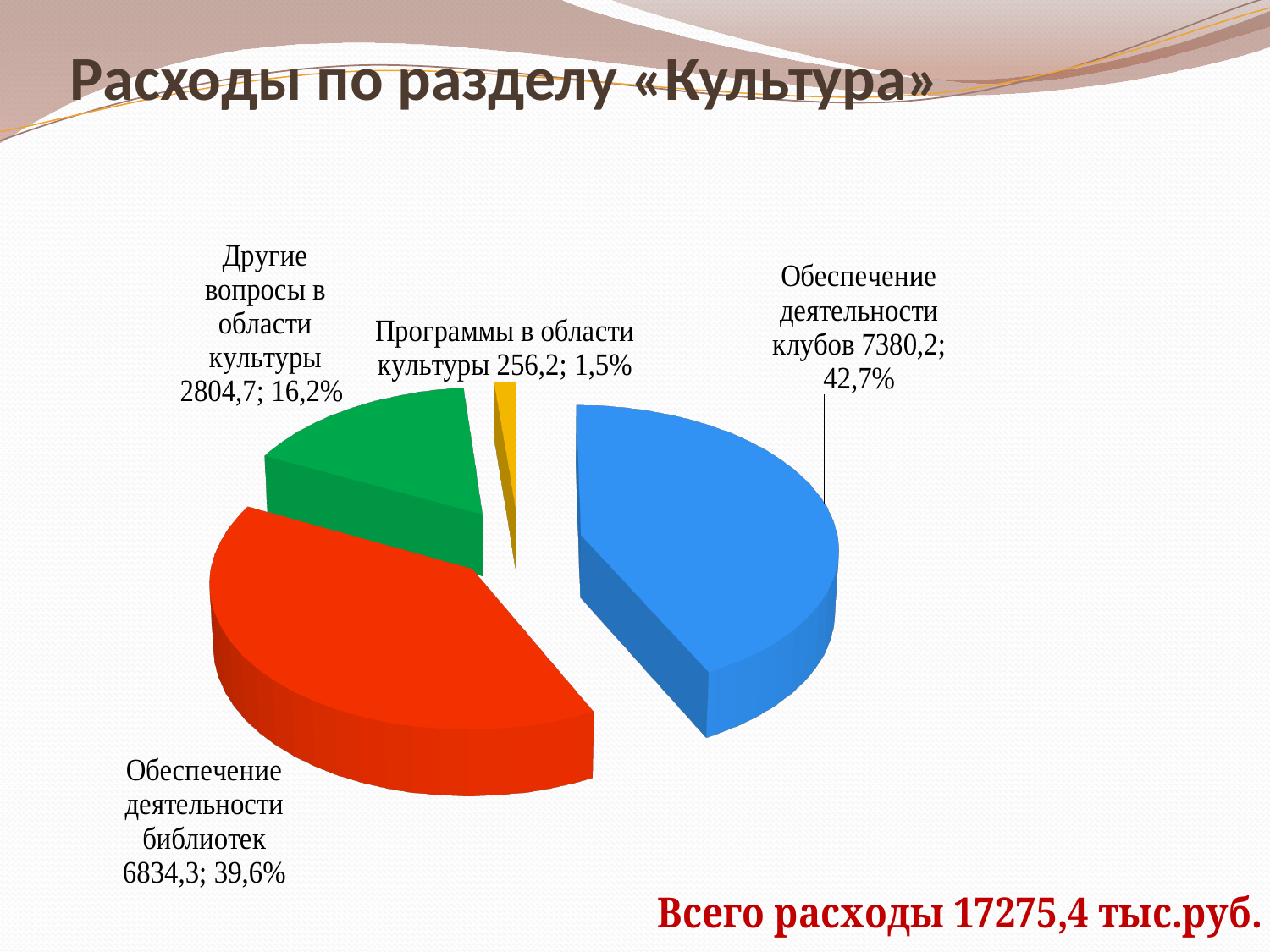
What is the title of the chart on the slide? Расходы по разделу «Культура» How many slices does the pie chart have? 4 What is the value for Другие вопросы в области культуры? 2804,7 What is the value for Обеспечение деятельности библиотек? 6834,3 Which category has the smallest slice? Программы в области культуры What share of the pie does Программы в области культуры represent? 1,5% What is the difference between the values for Обеспечение деятельности клубов and Обеспечение деятельности библиотек? 545,9 What kind of chart is shown on the slide? pie chart What is the value for Обеспечение деятельности клубов? 7380,2 What is the value for Программы в области культуры? 256,2 Which category has the largest slice? Обеспечение деятельности клубов What share of the pie does Обеспечение деятельности библиотек represent? 39,6%